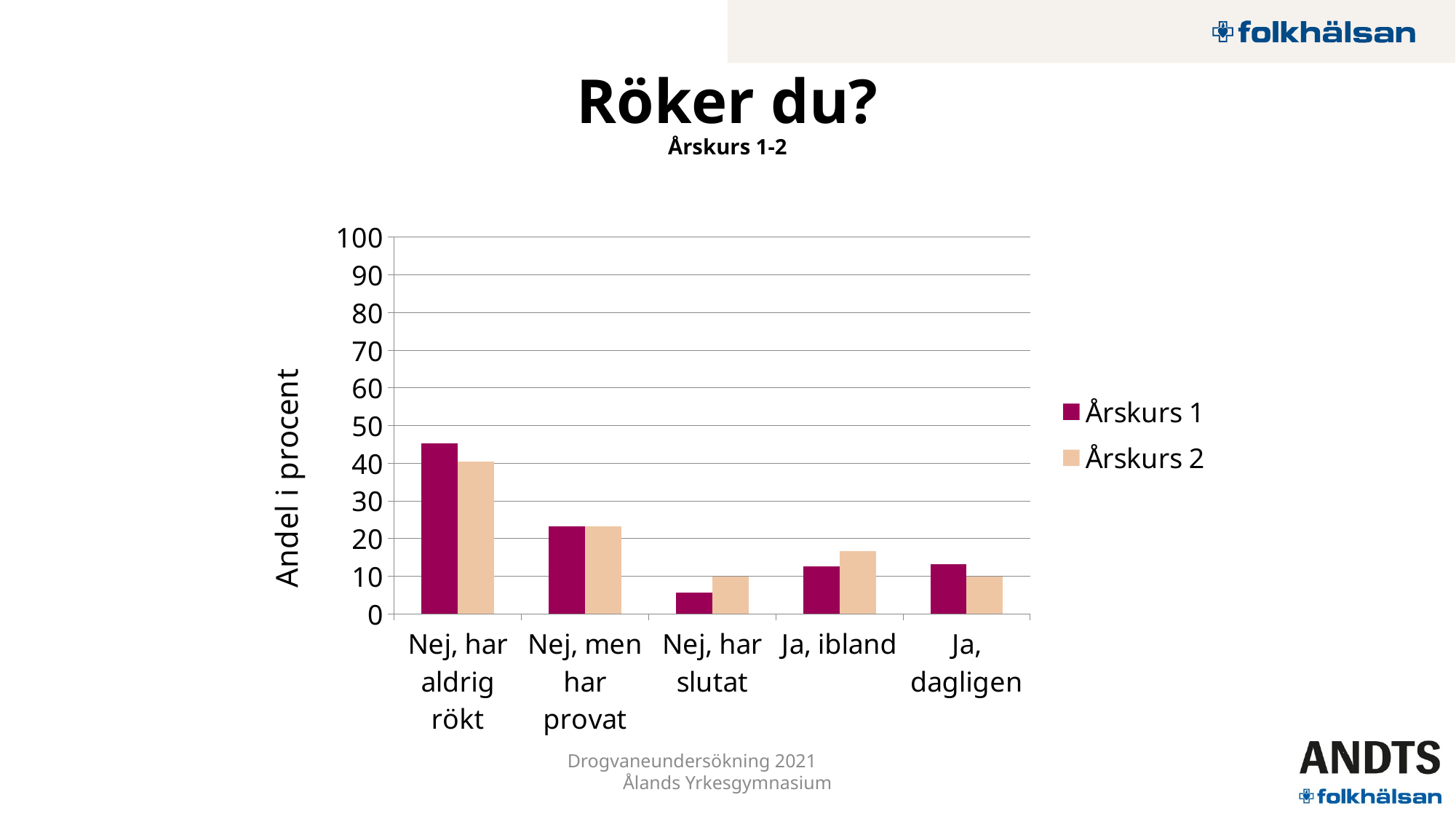
Which category has the lowest value for Årskurs 1? Nej, har slutat Is the value for Årskurs 2 in 'Ja, ibland' greater or less than 20? less How many categories are shown on the x axis? 5 Is the value for Årskurs 1 in 'Nej, har slutat' greater or less than 10? less Which category has the highest value for Årskurs 1? Nej, har aldrig rökt Which category has the highest value for Årskurs 2? Nej, har aldrig rökt For 'Ja, ibland', which series has the larger value, Årskurs 1 or Årskurs 2? Årskurs 2 What kind of chart is shown on the slide? bar chart Is the value for Årskurs 1 in 'Nej, har aldrig rökt' greater or less than 40? greater How many series does the legend list? 2 For 'Nej, har aldrig rökt', which series has the larger value, Årskurs 1 or Årskurs 2? Årskurs 1 What is the label of the y axis? Andel i procent